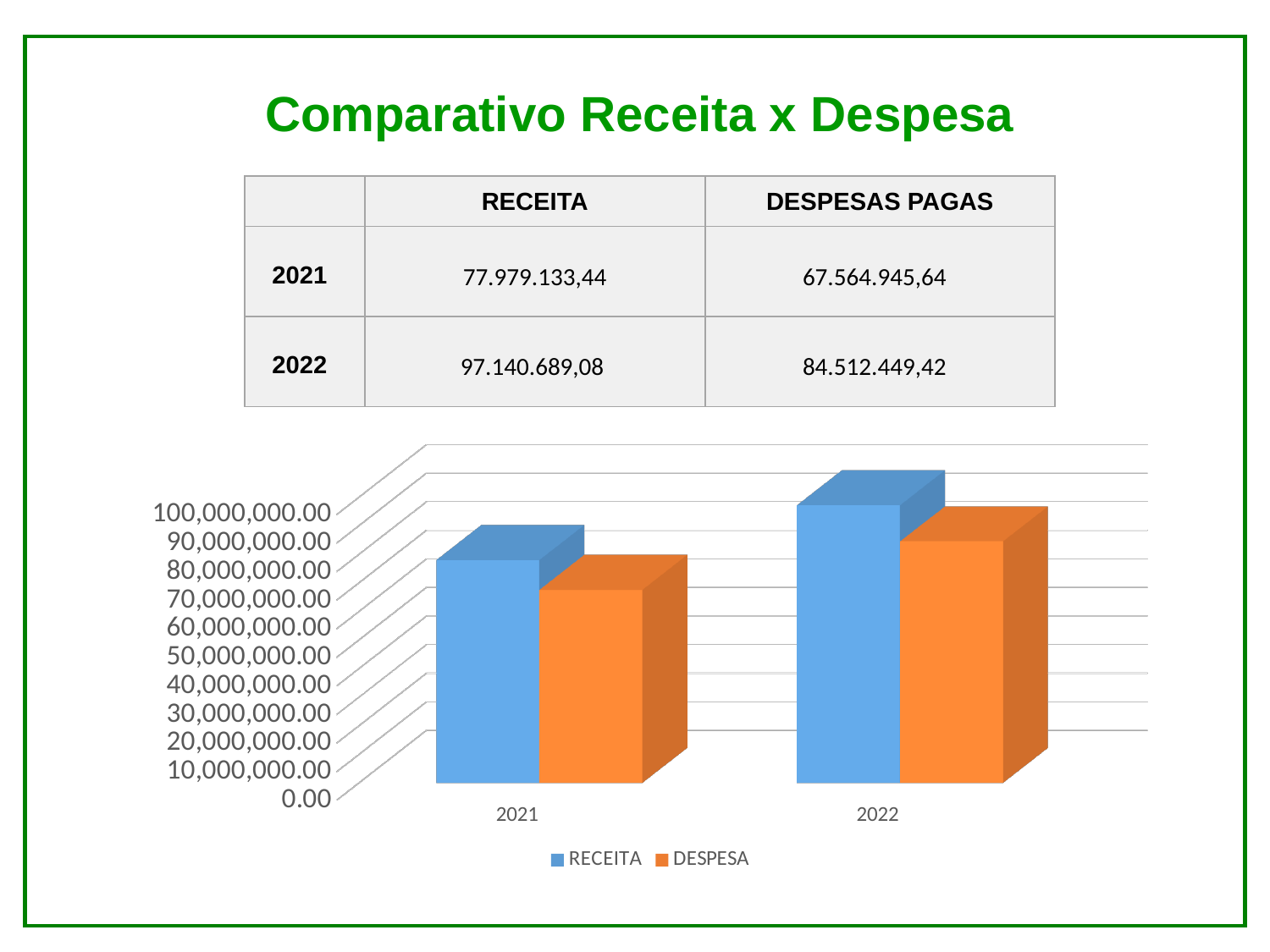
How many years are shown on the x axis of the chart? 2 What is the title of the slide above the chart? Comparativo Receita x Despesa What is the DESPESAS PAGAS value for 2022? 84.512.449,42 What kind of chart is shown on the slide? bar chart What is the RECEITA value for 2021? 77.979.133,44 Is the DESPESA value for 2021 greater or less than 80,000,000.00? less Does RECEITA rise or fall from 2021 to 2022? rise Which series is shown in orange in the chart? DESPESA Is the RECEITA value for 2022 greater or less than 90,000,000.00? greater How many series does the chart legend list? 2 In 2021, which is larger, RECEITA or DESPESA? RECEITA Which year has the higher RECEITA? 2022